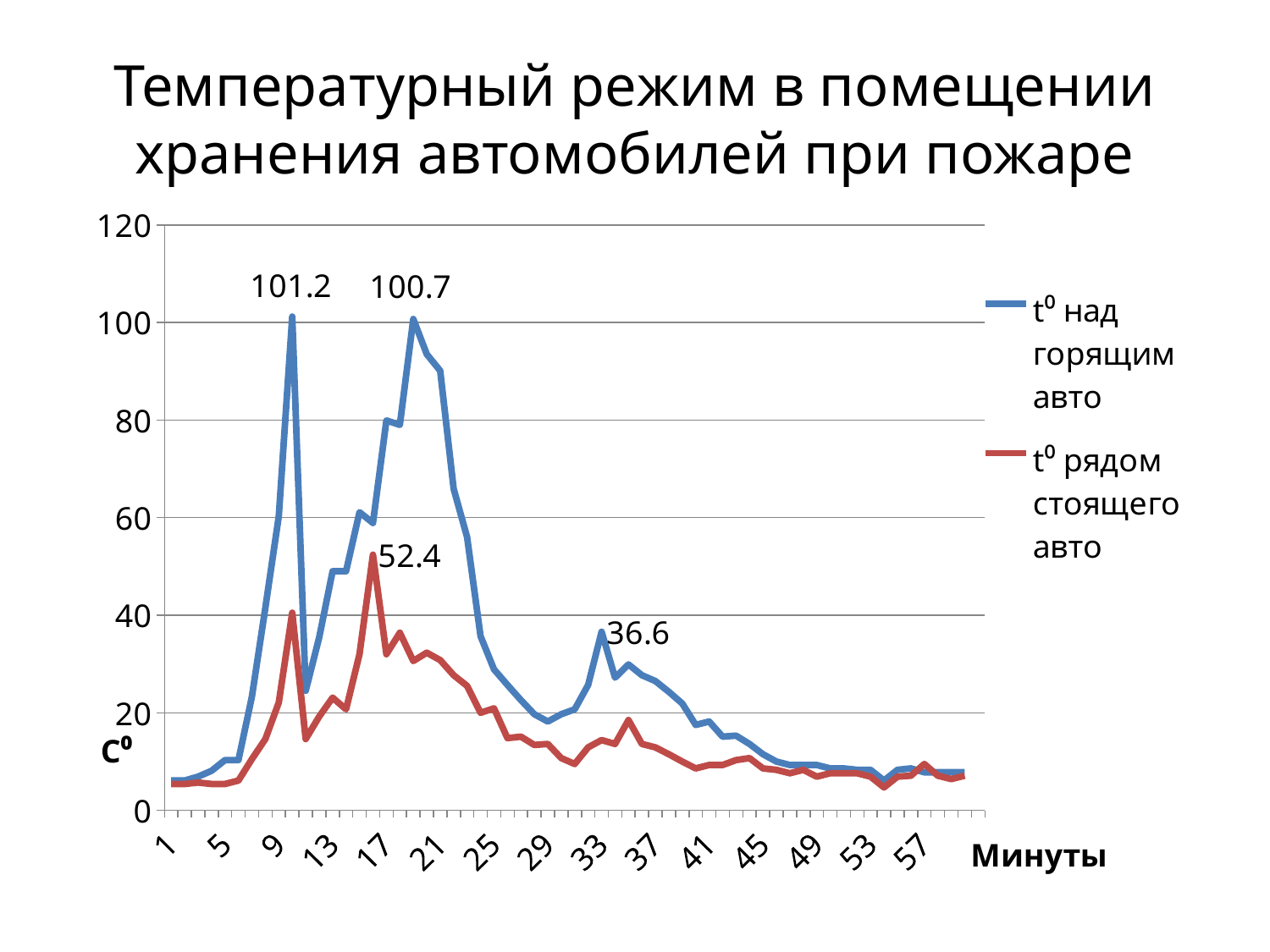
What is the highest labelled value of the series "t⁰ над горящим авто"? 101.2 After minute 21, does the series "t⁰ над горящим авто" generally rise or fall? fall What is the difference between the two labelled peaks 101.2 and 100.7 of the series "t⁰ над горящим авто"? 0.5 What is the label on the x axis of the chart? Минуты What is the labelled value of the small peak of the series "t⁰ над горящим авто" around minute 33? 36.6 What is the difference between the highest labelled value of "t⁰ над горящим авто" (101.2) and the labelled peak of "t⁰ рядом стоящего авто" (52.4)? 48.8 What is the labelled peak value of the series "t⁰ рядом стоящего авто"? 52.4 What kind of chart is shown on the slide? line chart Is the value of "t⁰ над горящим авто" at minute 1 greater or less than 20? less Which series reaches the higher peak temperature? t⁰ над горящим авто What is the labelled value of the second major peak of the series "t⁰ над горящим авто" (around minute 19)? 100.7 How many series does the legend list? 2